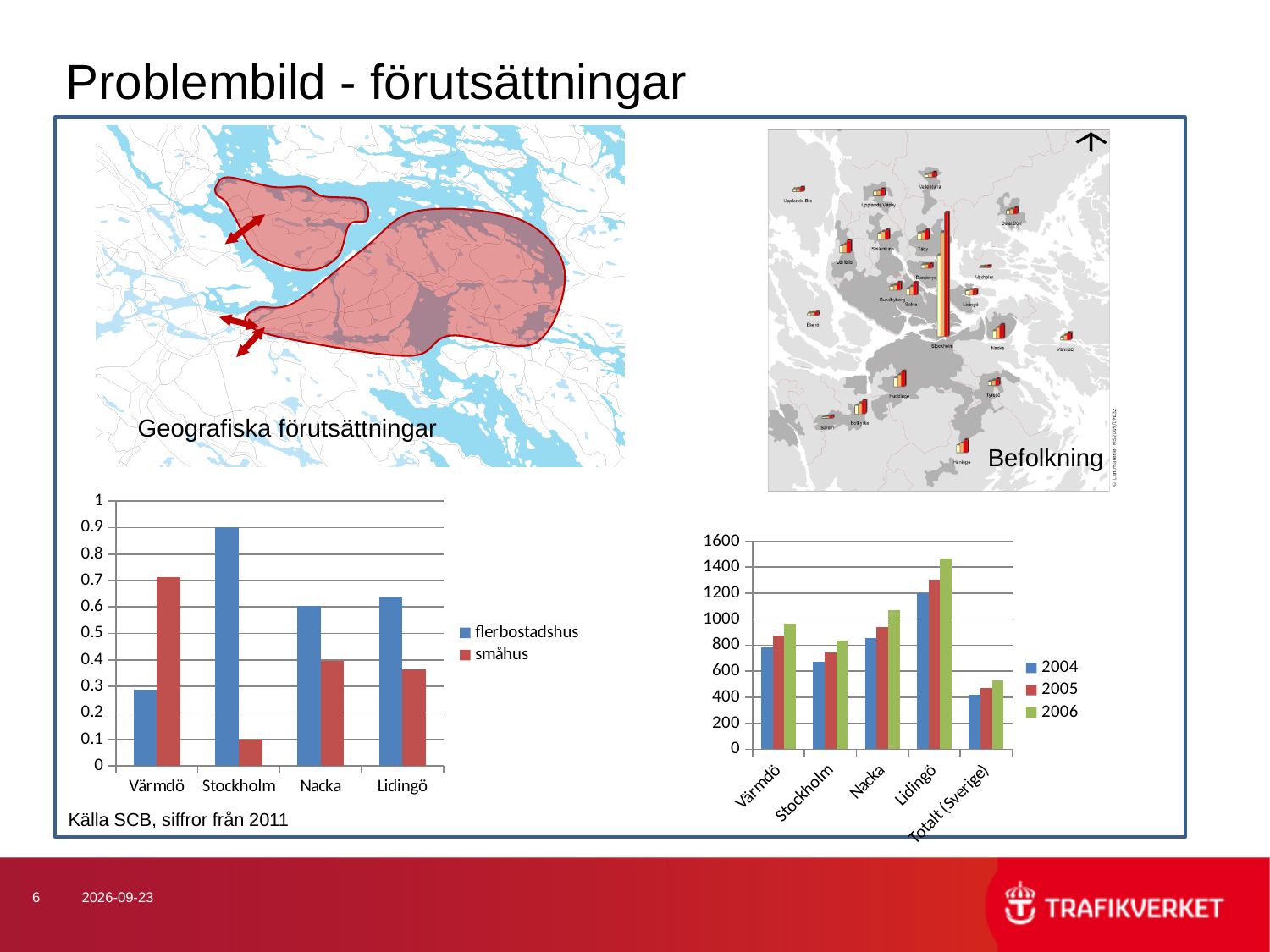
In the bottom-right chart, which category has the highest value for 2006? Lidingö In the bottom-left chart, which is larger for Lidingö: flerbostadshus or småhus? flerbostadshus In the bottom-right chart, is the value for Lidingö in 2006 greater or less than 1400? greater In the bottom-right chart, how many series does the legend list? 3 In the bottom-left chart, which category has the lowest value for småhus? Stockholm In the bottom-left chart, which category has the highest value for flerbostadshus? Stockholm In the bottom-left chart, how many series does the legend list? 2 In the bottom-left chart, is the value for flerbostadshus in Värmdö greater or less than 0.4? less In the bottom-left chart, how many categories are shown on the x axis? 4 What kind of chart is the bottom-left chart with the series flerbostadshus and småhus? bar chart In the bottom-right chart, how many categories are shown on the x axis? 5 In the bottom-right chart, do the values for Lidingö rise or fall from 2004 to 2006? rise